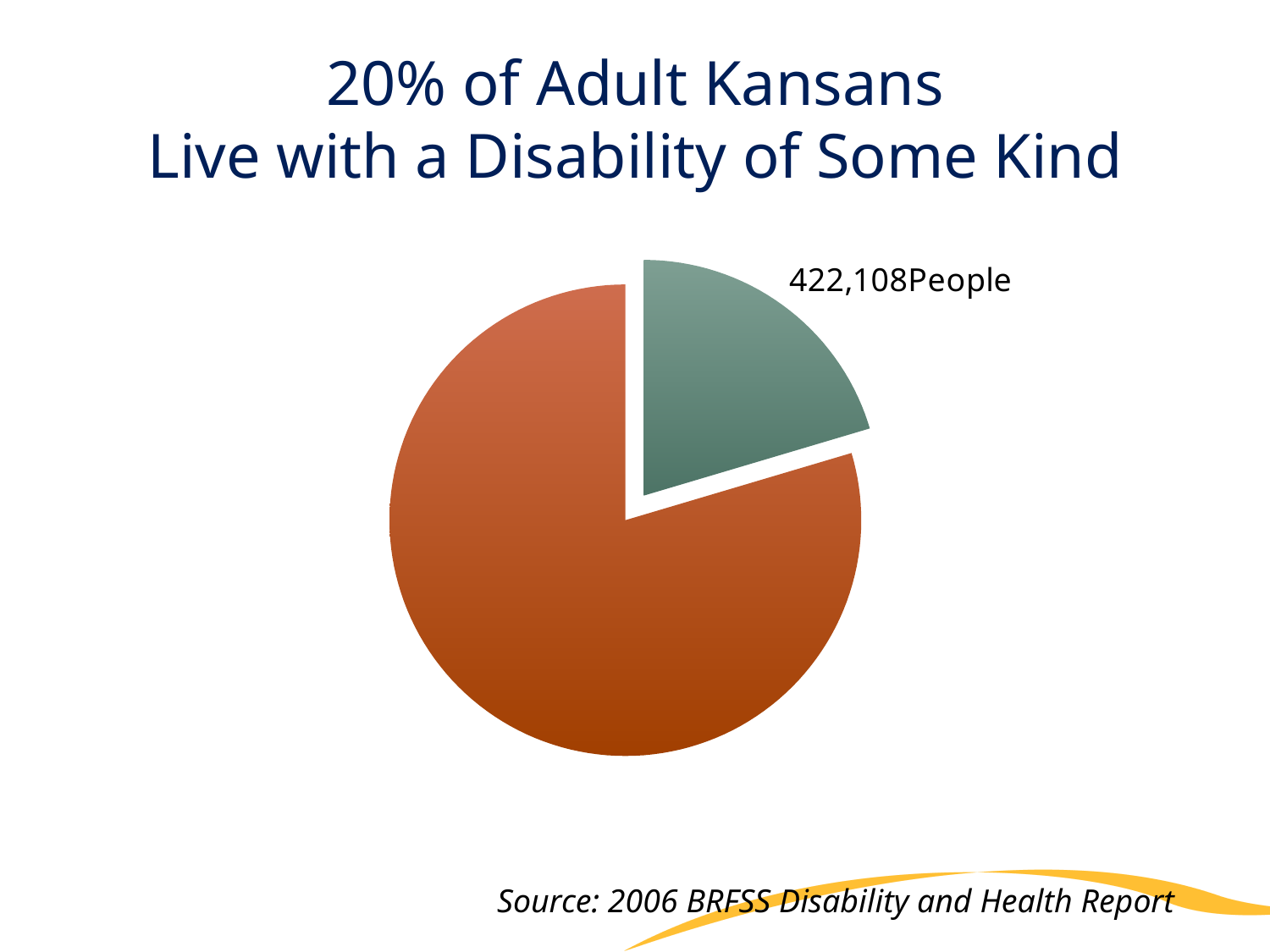
According to the slide, what share of adult Kansans live with a disability of some kind? 20% How many people does the exploded green slice of the pie chart represent? 422,108 What share of the pie does the large orange slice represent, given the 20% stated in the title? 80% Which slice of the pie chart is larger, the orange slice or the green slice? the orange slice What source is cited at the bottom of the slide? 2006 BRFSS Disability and Health Report What data label is printed next to the small green slice of the pie chart? 422,108People How many slices does the pie chart have? 2 What kind of chart is shown on the slide? pie chart What is the title of the slide? 20% of Adult Kansans Live with a Disability of Some Kind